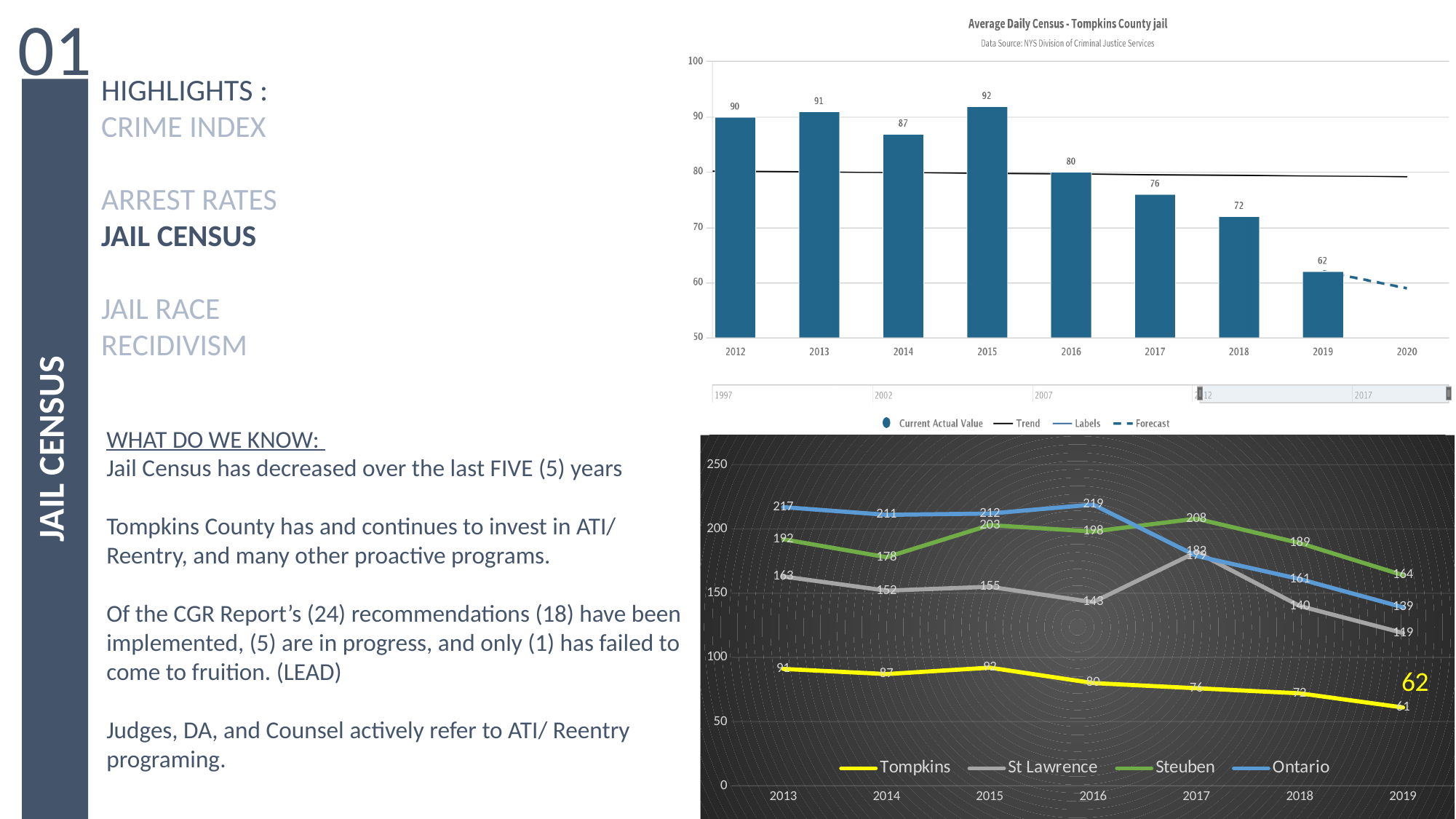
In the top chart, Average Daily Census - Tompkins County jail, what is the value for 2019? 62 In the bottom line chart, which is larger in 2014: Ontario or St Lawrence? Ontario In the top chart, Average Daily Census - Tompkins County jail, what is the value for 2015? 92 In the bottom line chart, how many series does the legend list? 4 In the top chart, Average Daily Census - Tompkins County jail, which year has the highest value? 2015 In the bottom line chart, what is the value for Steuben in 2017? 208 In the top chart, Average Daily Census - Tompkins County jail, how many years have bars plotted? 8 In the top chart, Average Daily Census - Tompkins County jail, what is the difference between the 2012 value and the 2018 value? 18 What kind of chart is the top chart, Average Daily Census - Tompkins County jail? bar chart In the bottom line chart, do the Tompkins values generally rise or fall from 2013 to 2019? fall In the top chart, Average Daily Census - Tompkins County jail, which year has the lowest value? 2019 In the bottom line chart, what is the value for Ontario in 2019? 139